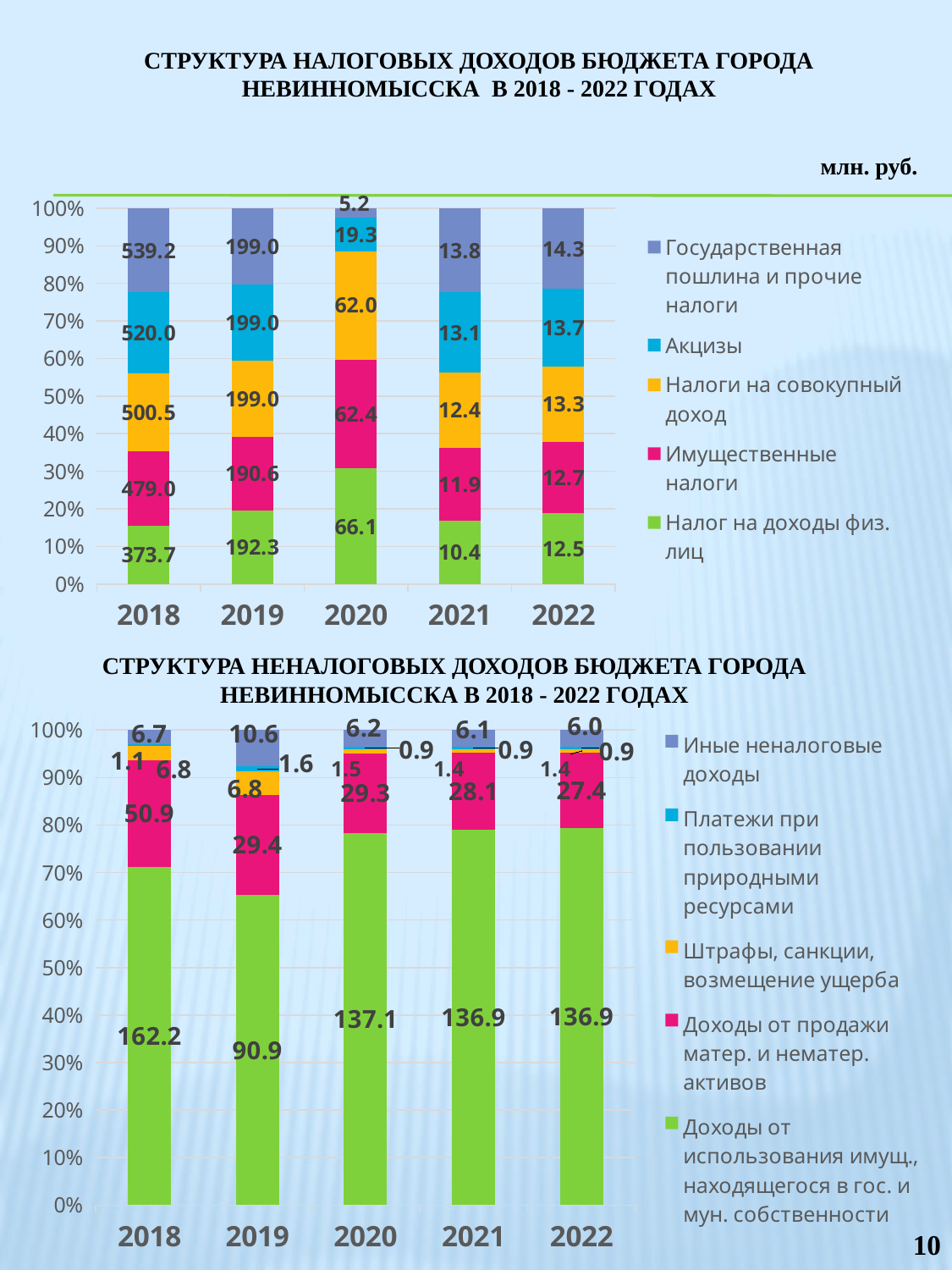
In the top chart (tax revenue structure), what is the value labelled for Акцизы in 2020? 19.3 What type of chart is the bottom chart (non-tax revenue structure)? Stacked bar chart In the top chart (tax revenue structure), how many series does the legend list? 5 In the top chart (tax revenue structure), what is the value labelled for Государственная пошлина и прочие налоги in 2022? 14.3 In the top chart (tax revenue structure), what is the difference between the Имущественные налоги labels for 2018 and 2019? 288.4 In the bottom chart (non-tax revenue structure), what is the value labelled for Доходы от продажи матер. и нематер. активов in 2019? 29.4 In the top chart (tax revenue structure), what is the value labelled for Налог на доходы физ. лиц in 2018? 373.7 In the top chart (tax revenue structure), which year has the highest labelled value for Налоги на совокупный доход? 2018 In the bottom chart (non-tax revenue structure), is the labelled value for Доходы от продажи матер. и нематер. активов larger in 2018 or in 2022? 2018 In the bottom chart (non-tax revenue structure), which year has the lowest labelled value for Доходы от использования имущ., находящегося в гос. и мун. собственности? 2019 In the bottom chart (non-tax revenue structure), how many years are shown on the x axis? 5 In the bottom chart (non-tax revenue structure), what is the value labelled for Иные неналоговые доходы in 2019? 10.6